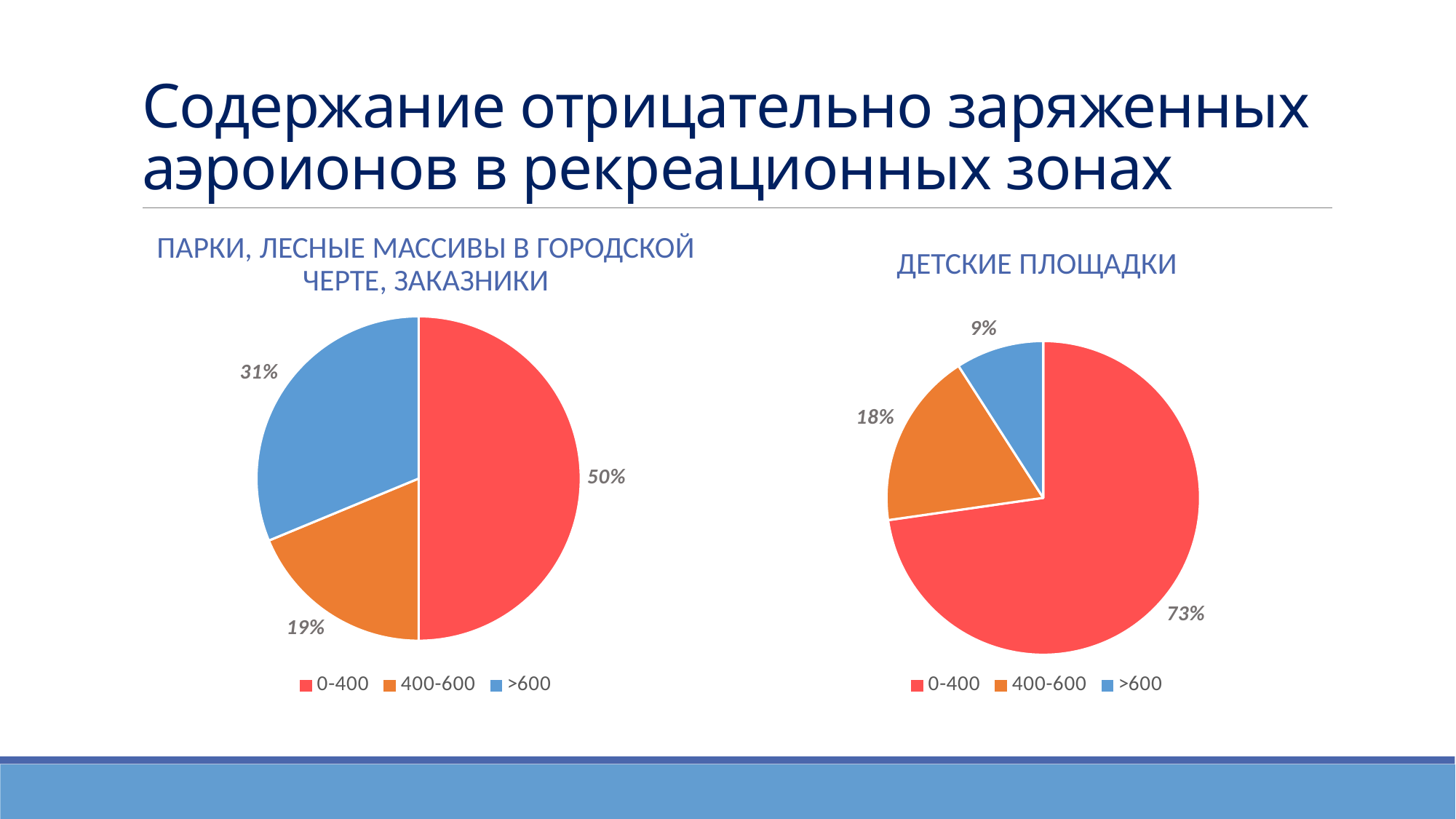
How many categories does the legend of the left chart (ПАРКИ, ЛЕСНЫЕ МАССИВЫ В ГОРОДСКОЙ ЧЕРТЕ, ЗАКАЗНИКИ) list? 3 In the right chart (ДЕТСКИЕ ПЛОЩАДКИ), what is the value for 400-600? 18% What kind of chart is the right chart (ДЕТСКИЕ ПЛОЩАДКИ)? Pie chart In the left chart (ПАРКИ, ЛЕСНЫЕ МАССИВЫ В ГОРОДСКОЙ ЧЕРТЕ, ЗАКАЗНИКИ), what share does the 0-400 slice have? 50% In the right chart (ДЕТСКИЕ ПЛОЩАДКИ), which is larger: the 400-600 slice or the >600 slice? 400-600 In the left chart (ПАРКИ, ЛЕСНЫЕ МАССИВЫ В ГОРОДСКОЙ ЧЕРТЕ, ЗАКАЗНИКИ), what is the difference between the 0-400 and >600 slices? 19% In the right chart (ДЕТСКИЕ ПЛОЩАДКИ), what is the value for >600? 9% In the left chart (ПАРКИ, ЛЕСНЫЕ МАССИВЫ В ГОРОДСКОЙ ЧЕРТЕ, ЗАКАЗНИКИ), which category has the largest slice? 0-400 In the right chart (ДЕТСКИЕ ПЛОЩАДКИ), what share does the 0-400 slice have? 73% In the left chart (ПАРКИ, ЛЕСНЫЕ МАССИВЫ В ГОРОДСКОЙ ЧЕРТЕ, ЗАКАЗНИКИ), what share does the >600 slice have? 31% In the left chart (ПАРКИ, ЛЕСНЫЕ МАССИВЫ В ГОРОДСКОЙ ЧЕРТЕ, ЗАКАЗНИКИ), what is the value for 400-600? 19% In the right chart (ДЕТСКИЕ ПЛОЩАДКИ), which category has the smallest slice? >600